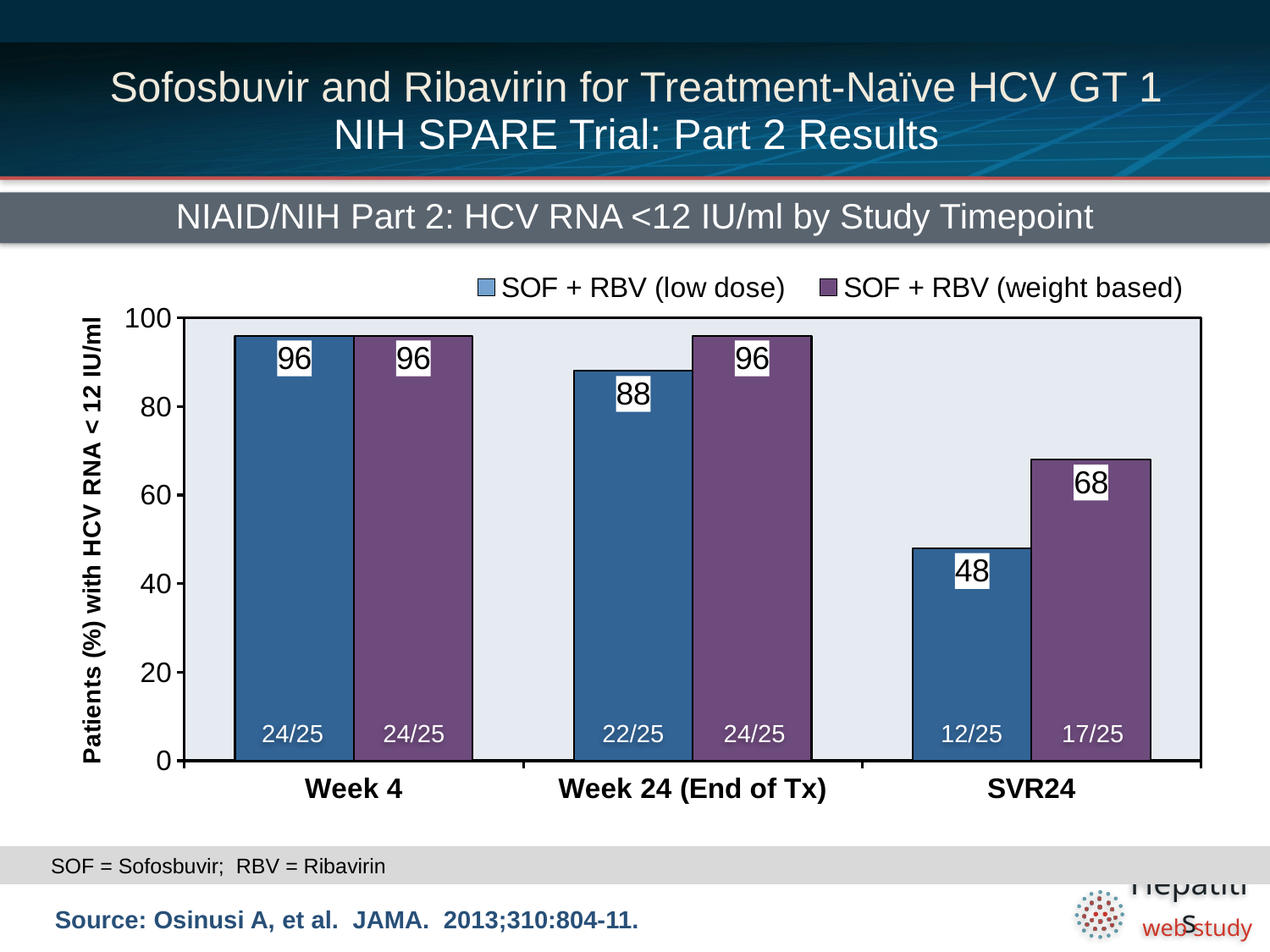
At Week 24 (End of Tx), which series has the larger value, SOF + RBV (low dose) or SOF + RBV (weight based)? SOF + RBV (weight based) At which timepoint is the SOF + RBV (low dose) value lowest? SVR24 Do the SOF + RBV (low dose) values rise or fall from Week 4 to SVR24? Fall What kind of chart is shown on the slide? Bar chart What is the value for SOF + RBV (weight based) at SVR24? 68 What is the value for SOF + RBV (low dose) at SVR24? 48 What fraction of patients is shown for SOF + RBV (weight based) at Week 24 (End of Tx)? 24/25 What is the value for SOF + RBV (low dose) at Week 24 (End of Tx)? 88 How many series does the legend list? 2 What is the difference between the SOF + RBV (weight based) and SOF + RBV (low dose) values at SVR24? 20 How many timepoint categories are shown on the x axis? 3 What is the label of the y axis? Patients (%) with HCV RNA < 12 IU/ml